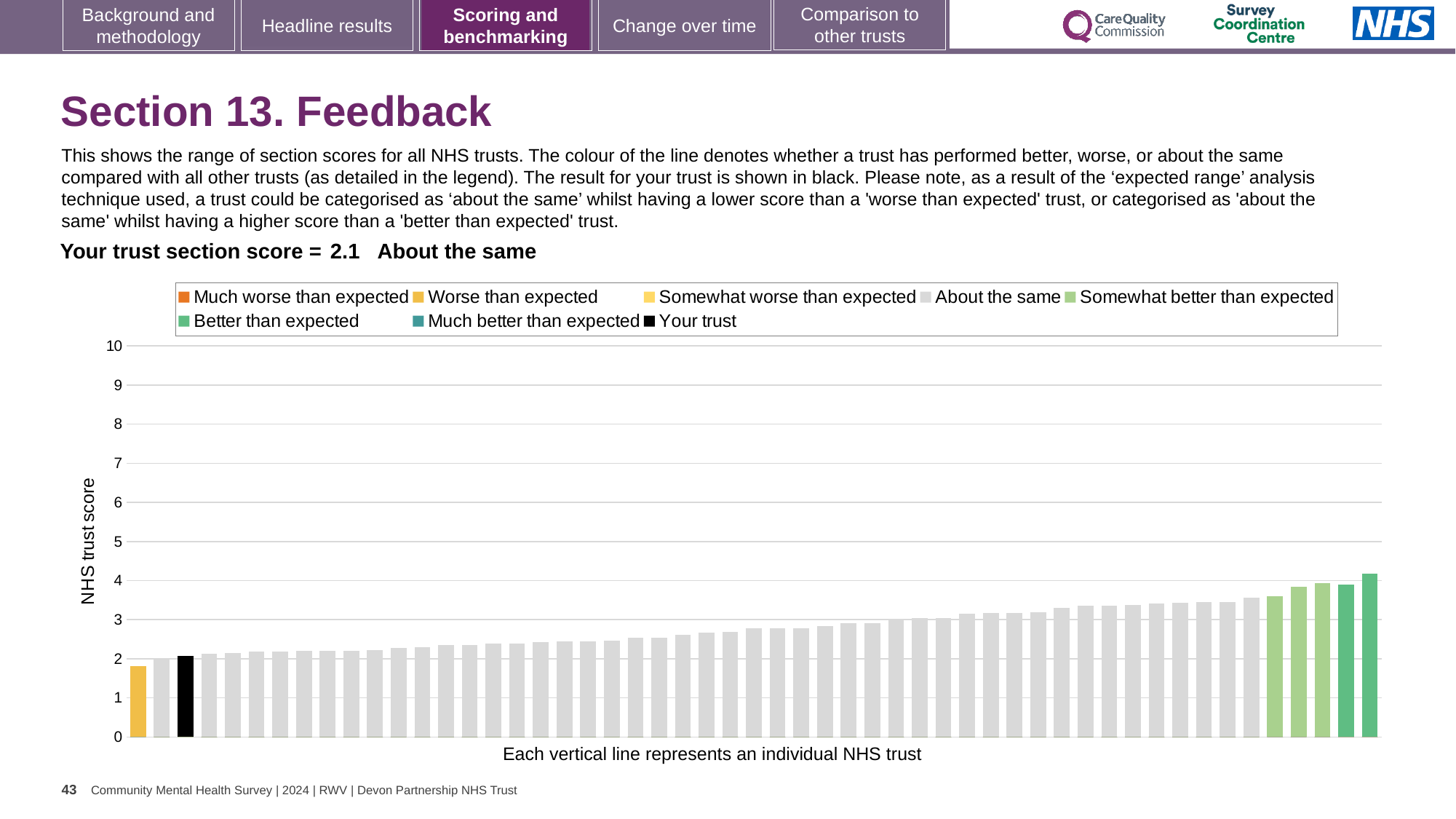
Is the value for your trust's bar greater or less than 3? less Do the bar values rise or fall from left to right along the x axis? rise Is the value of the leftmost bar greater or less than 2? less What colour is the bar representing your trust? black How many entries does the chart legend list? 8 Is the value of the tallest bar greater or less than 4? greater Which legend category does the tallest bar on the right belong to? Better than expected What kind of chart is shown on the slide? bar chart What is the label on the vertical axis of the chart? NHS trust score Which performance category is your trust placed in for Section 13. Feedback? About the same Is your trust's bar higher or lower than the leftmost bar? higher What is the section score for your trust shown on the slide? 2.1